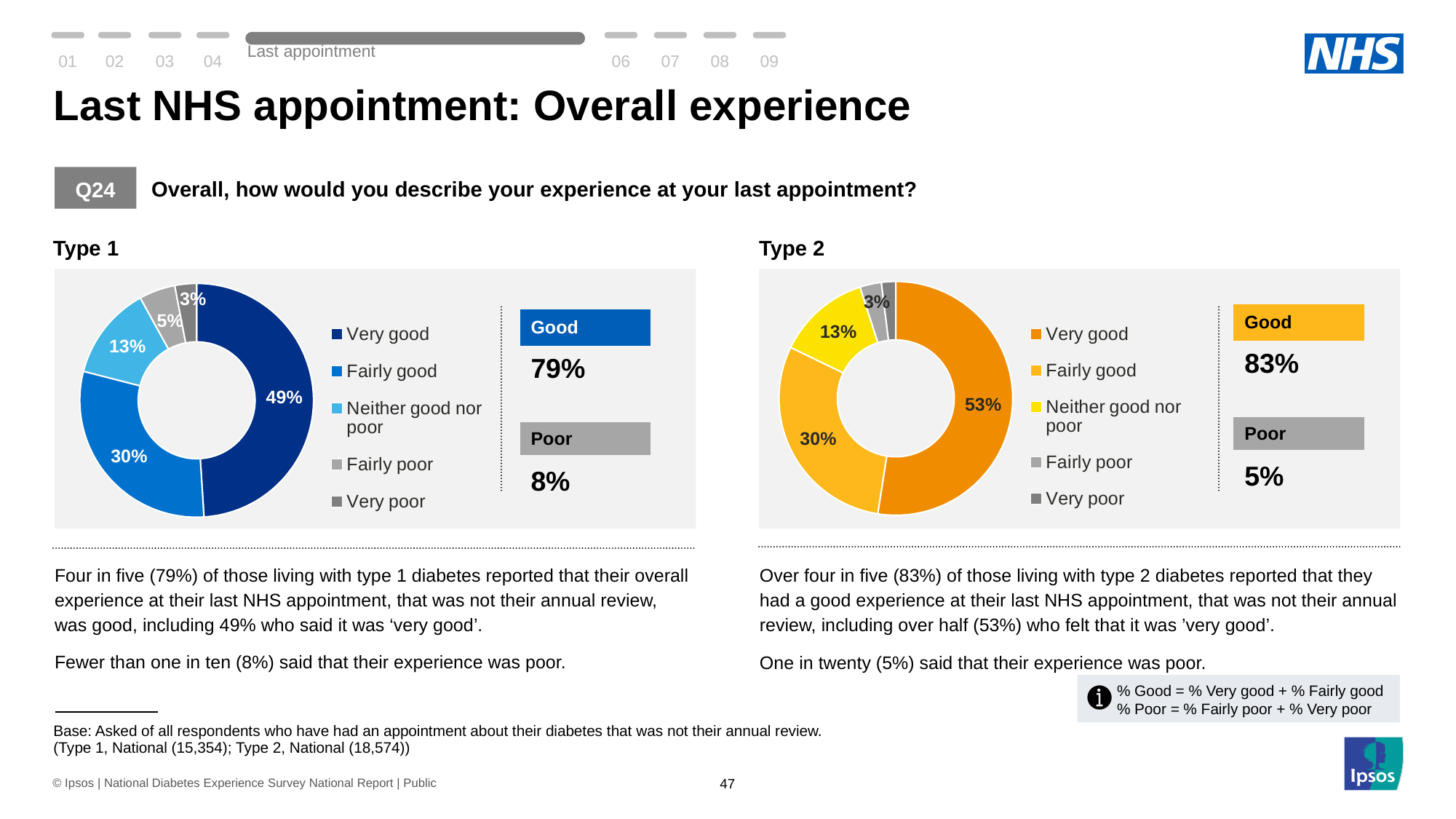
In the Type 2 chart, what percentage of respondents said their experience was 'Very good'? 53% What is the difference between the 'Very good' share in the Type 2 chart and the 'Very good' share in the Type 1 chart? 4 percentage points What is the combined 'Poor' percentage shown next to the Type 1 chart? 8% In the Type 2 chart, which category has the largest share? Very good How many categories does the legend of the Type 1 chart list? 5 In the Type 1 chart, what percentage of respondents said their experience was 'Fairly good'? 30% Which is larger: the 'Very good' share in the Type 1 chart or the 'Very good' share in the Type 2 chart? Type 2 In the Type 1 chart, what percentage of respondents said their experience was 'Very good'? 49% In the Type 2 chart, what percentage of respondents said their experience was 'Neither good nor poor'? 13% What is the combined 'Good' percentage shown next to the Type 2 chart? 83% In the Type 1 chart, what percentage of respondents said their experience was 'Fairly poor'? 5% In the Type 1 chart, which category has the largest share? Very good